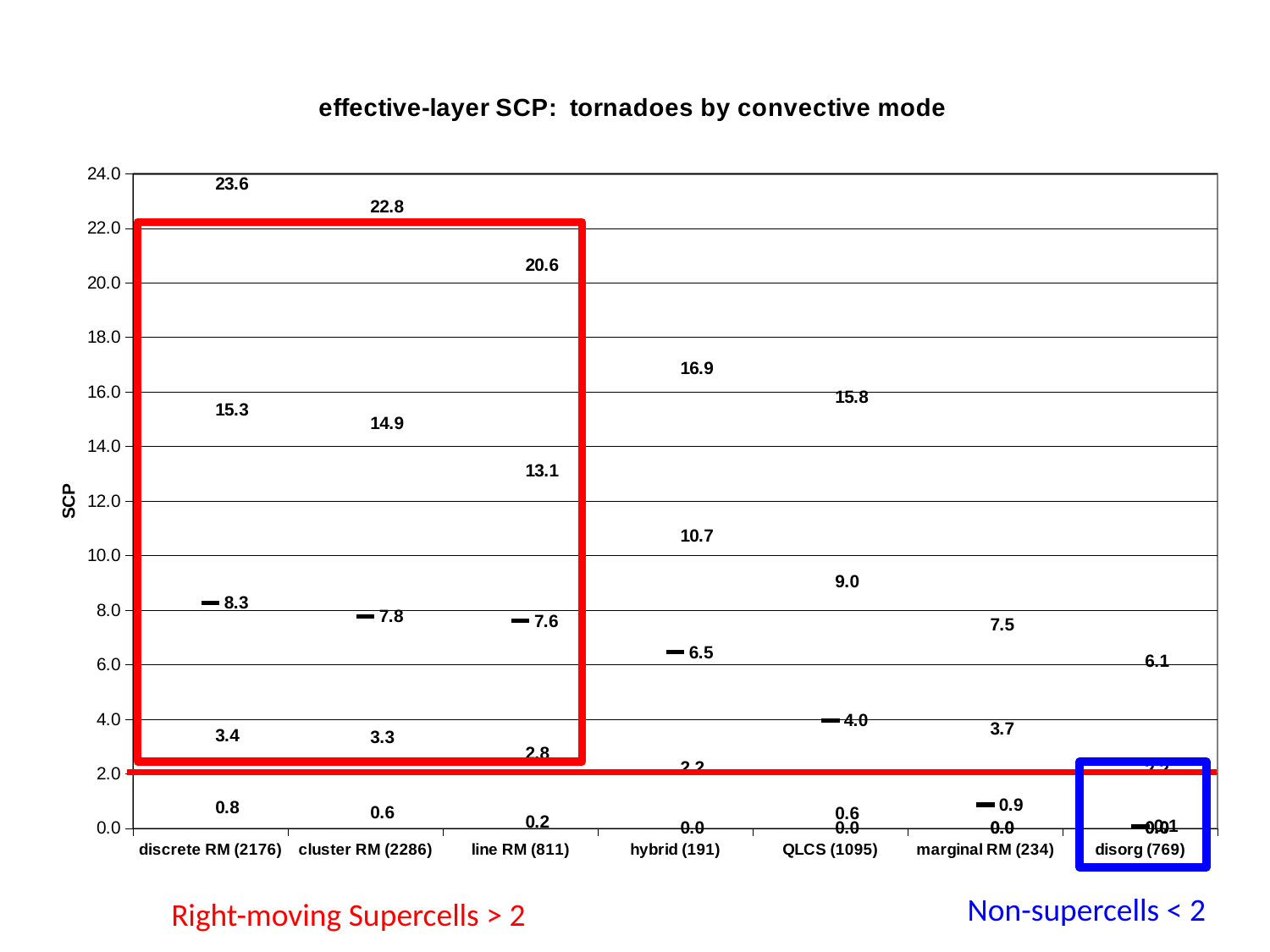
Which category has the highest labelled value on the chart? discrete RM (2176) What is the title of the chart? effective-layer SCP: tornadoes by convective mode What is the difference between the marker values for discrete RM (2176) and cluster RM (2286)? 0.5 Which is larger, the marker value for hybrid (191) or the marker value for QLCS (1095)? hybrid (191) What is the value at the marker for QLCS (1095)? 4.0 How many convective mode categories are shown along the x axis? 7 What is the label on the vertical axis of the chart? SCP What is the value at the marker for discrete RM (2176)? 8.3 What is the highest value labelled for discrete RM (2176)? 23.6 What is the highest value labelled for line RM (811)? 20.6 What is the value at the marker for marginal RM (234)? 0.9 What is the highest value labelled for cluster RM (2286)? 22.8